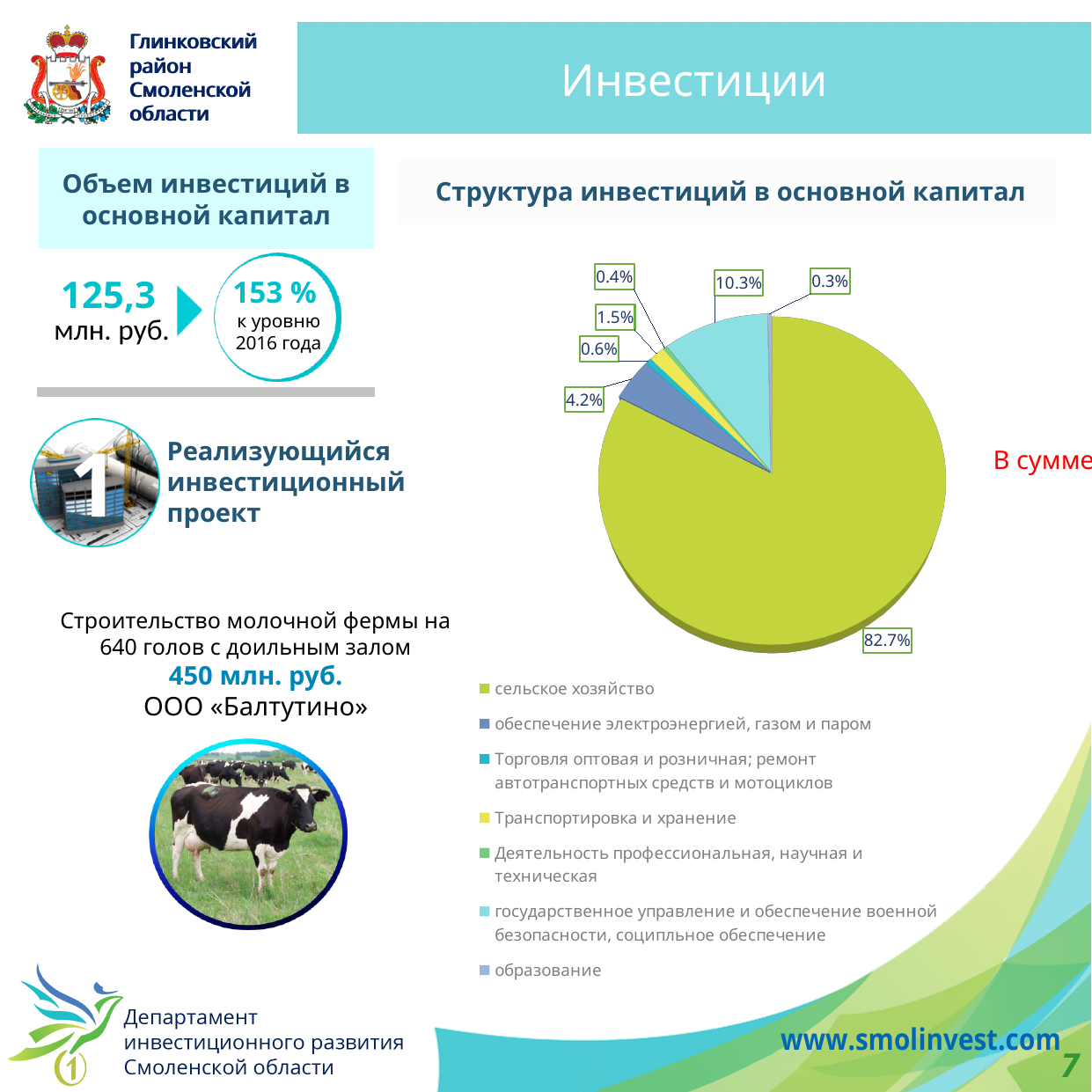
In the pie chart, what share does "сельское хозяйство" have? 82.7% What kind of chart is shown under the title "Структура инвестиций в основной капитал"? pie chart In the pie chart, what is the value for "образование"? 0.3% Which category has the largest slice in the pie chart? сельское хозяйство In the pie chart, what is the value for "государственное управление и обеспечение военной безопасности, соципльное обеспечение"? 10.3% What colour is the slice for "сельское хозяйство" in the pie chart? yellow-green How many categories does the pie chart's legend list? 7 In the pie chart, which is larger: "обеспечение электроэнергией, газом и паром" or "Транспортировка и хранение"? обеспечение электроэнергией, газом и паром Which category has the smallest slice in the pie chart? образование In the pie chart, what is the value for "обеспечение электроэнергией, газом и паром"? 4.2% In the pie chart, what is the value for "Транспортировка и хранение"? 1.5% In the pie chart, what is the difference between the shares of "сельское хозяйство" and "государственное управление и обеспечение военной безопасности, соципльное обеспечение"? 72.4%